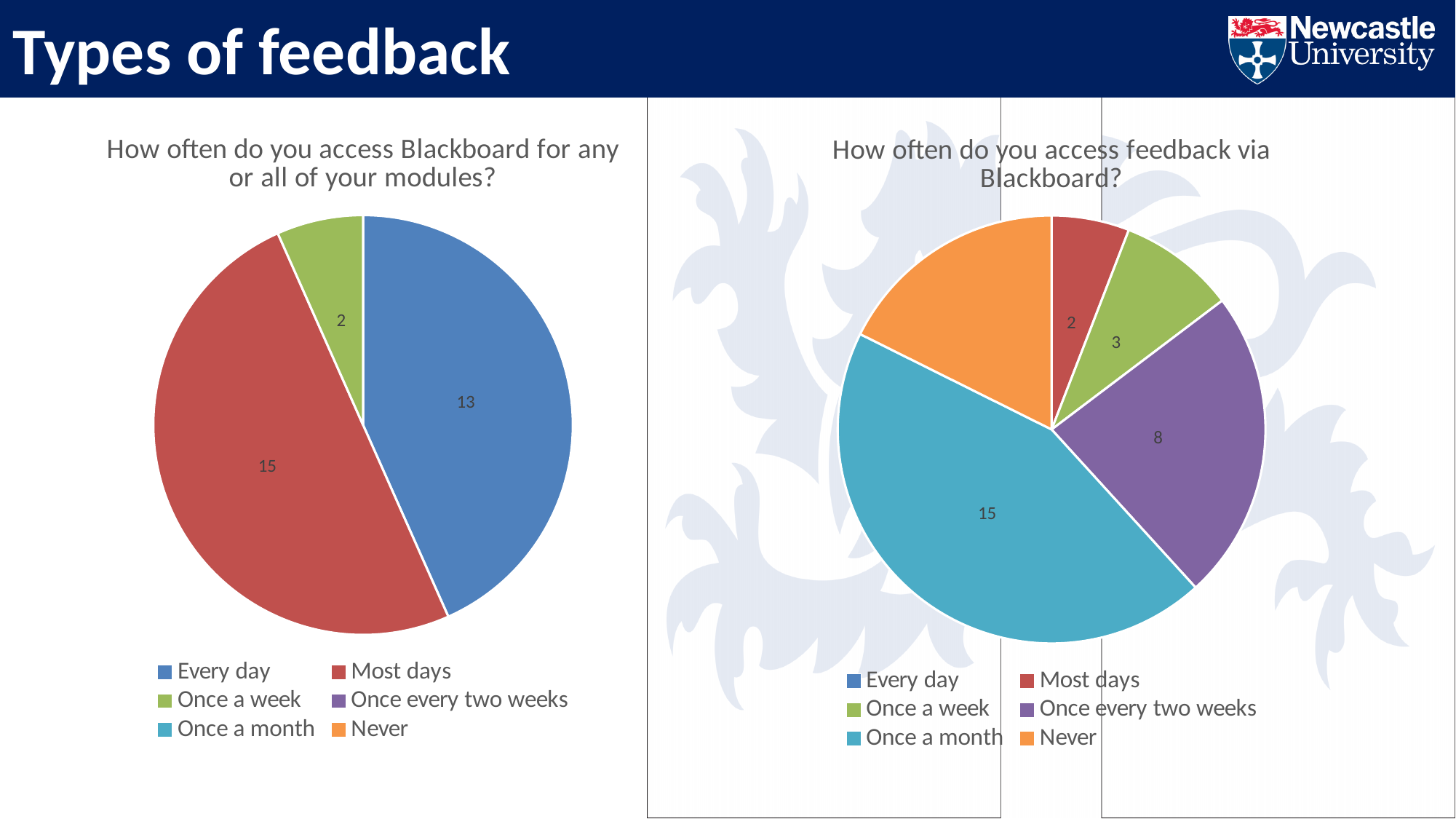
In the left pie chart (How often do you access Blackboard for any or all of your modules?), what is the difference between Most days and Every day? 2 In the left pie chart (How often do you access Blackboard for any or all of your modules?), which category has the largest slice? Most days In the right pie chart (How often do you access feedback via Blackboard?), which is larger, Once a week or Once every two weeks? Once every two weeks In the right pie chart (How often do you access feedback via Blackboard?), which category has the largest slice? Once a month In the right pie chart (How often do you access feedback via Blackboard?), what is the value for Once every two weeks? 8 In the left pie chart (How often do you access Blackboard for any or all of your modules?), what is the value for Most days? 15 In the left pie chart (How often do you access Blackboard for any or all of your modules?), what share of the pie does Most days represent? 50% What type of chart is used on this slide? Pie chart In the right pie chart (How often do you access feedback via Blackboard?), what is the difference between Once a month and Once every two weeks? 7 In the right pie chart (How often do you access feedback via Blackboard?), what is the value for Once a month? 15 In the left pie chart (How often do you access Blackboard for any or all of your modules?), what is the value for Every day? 13 In the left pie chart (How often do you access Blackboard for any or all of your modules?), how many slices are shown? 3